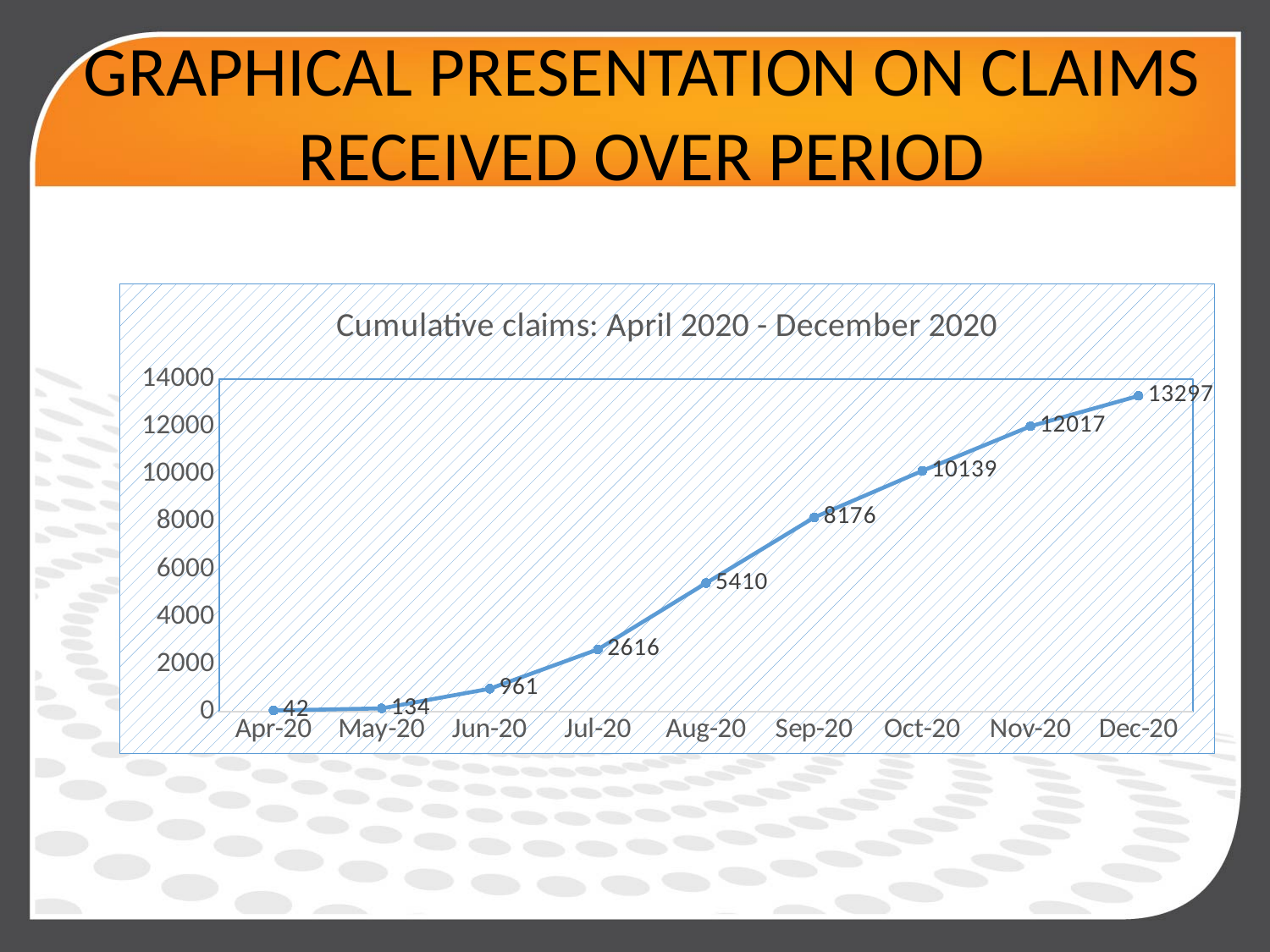
Which month has the lowest cumulative claims value? Apr-20 What is the cumulative claims value for Dec-20? 13297 Which month has the highest cumulative claims value? Dec-20 What is the cumulative claims value for Jun-20? 961 Which is larger, the value for Jul-20 or the value for Oct-20? Oct-20 What is the difference between the cumulative claims for Dec-20 and Nov-20? 1280 What is the cumulative claims value for Aug-20? 5410 What kind of chart is shown on the slide? Line chart Do the cumulative claims rise or fall from Apr-20 to Dec-20? Rise How many months are plotted on the chart? 9 Is the value for Nov-20 greater or less than 10000? greater What is the difference between the cumulative claims for Sep-20 and Aug-20? 2766